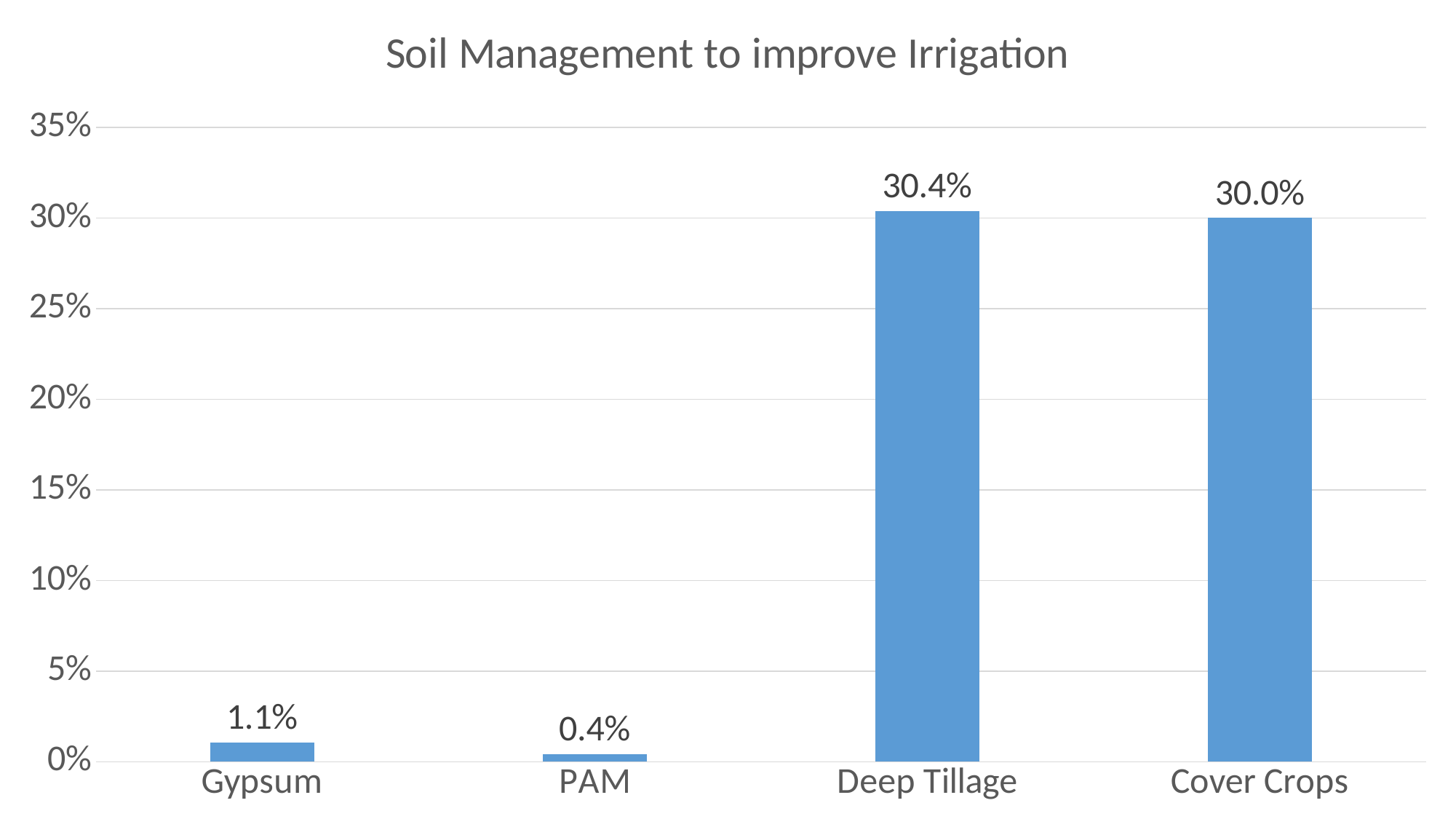
Which category has the lowest value? PAM How many categories are shown on the x axis? 4 What is the value for Cover Crops? 30.0% Is the value for Cover Crops greater or less than 25%? greater Which is larger, the value for Gypsum or the value for Deep Tillage? Deep Tillage What is the difference between the values for Gypsum and PAM? 0.7% What is the value for PAM? 0.4% What is the difference between the values for Deep Tillage and Cover Crops? 0.4% What is the value for Gypsum? 1.1% What is the title of the chart? Soil Management to improve Irrigation What is the value for Deep Tillage? 30.4% What kind of chart is shown on the slide? bar chart